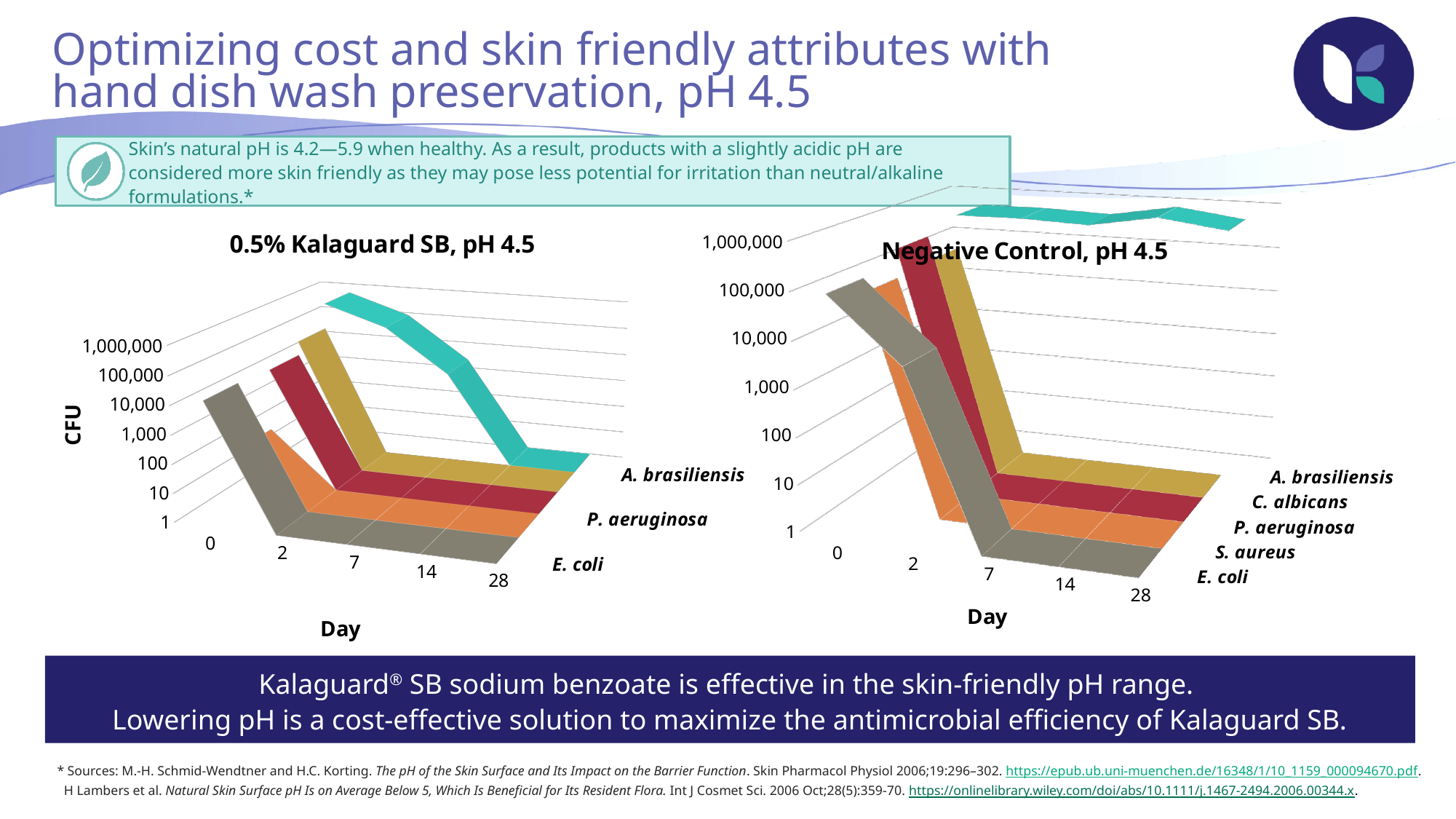
In the "Negative Control, pH 4.5" chart, how many days are shown on the x axis? 5 What is the title of the chart on the left? 0.5% Kalaguard SB, pH 4.5 In the "Negative Control, pH 4.5" chart, is the value for A. brasiliensis at day 28 greater or less than 10,000? greater In the "Negative Control, pH 4.5" chart, is the value for E. coli at day 28 greater or less than 100? less In the "Negative Control, pH 4.5" chart, what is the last day shown on the x axis? 28 What kind of chart is the "0.5% Kalaguard SB, pH 4.5" chart? 3D line (ribbon) chart In the "0.5% Kalaguard SB, pH 4.5" chart, what is the highest value shown on the CFU axis? 1,000,000 What is the title of the chart on the right? Negative Control, pH 4.5 In the "0.5% Kalaguard SB, pH 4.5" chart, how many days are shown on the x axis? 5 In the "Negative Control, pH 4.5" chart, how many organisms (series) are labelled? 5 In the "0.5% Kalaguard SB, pH 4.5" chart, is the value for E. coli at day 28 greater or less than 100? less In the "0.5% Kalaguard SB, pH 4.5" chart, do the CFU values for E. coli rise or fall from day 0 to day 28? fall